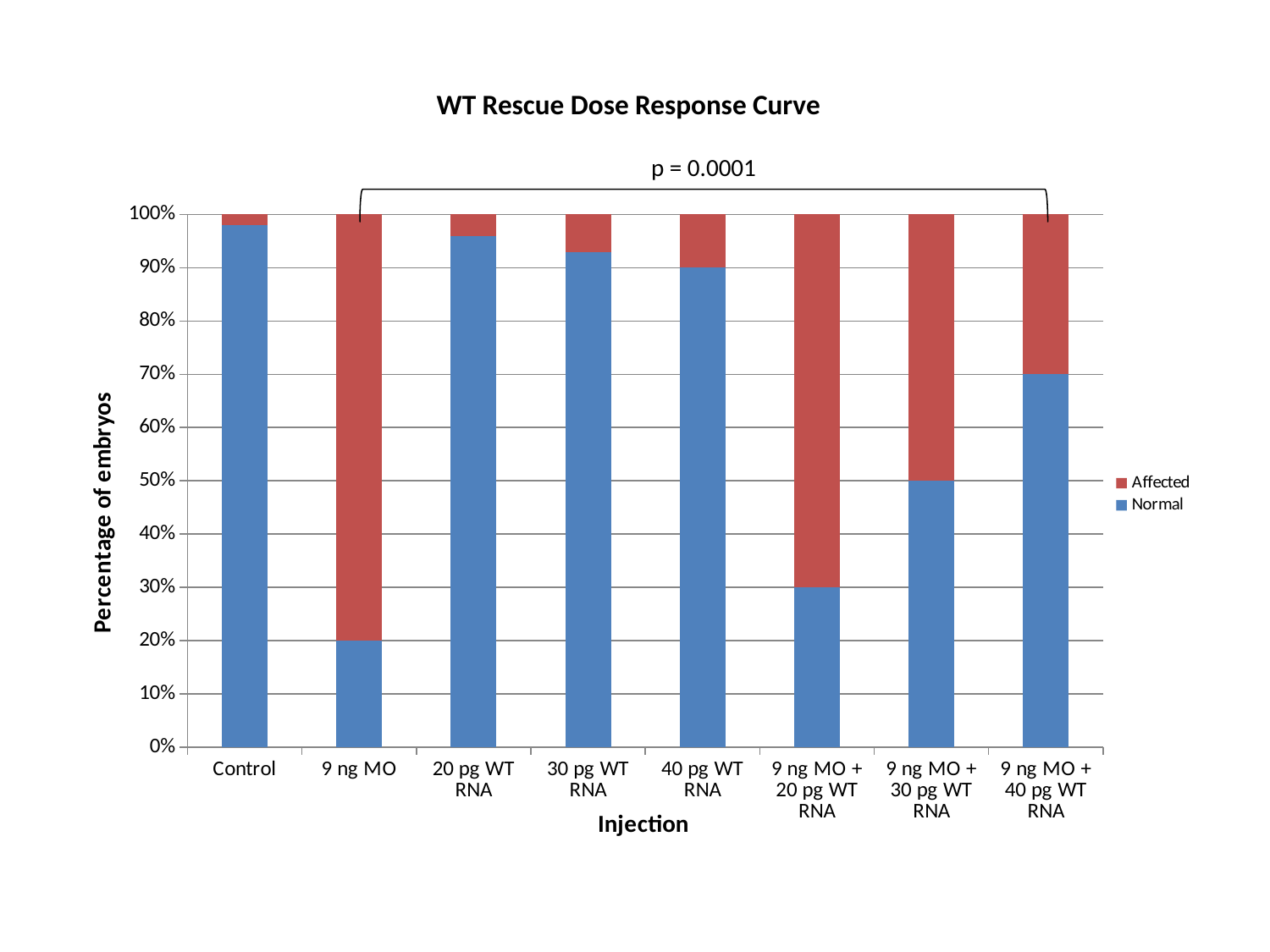
Is the Normal percentage for Control greater or less than 90%? greater Which has a higher Normal percentage: 9 ng MO + 20 pg WT RNA or 9 ng MO + 40 pg WT RNA? 9 ng MO + 40 pg WT RNA Which injection has the lowest Normal percentage? 9 ng MO What is the Normal percentage for the 9 ng MO + 30 pg WT RNA injection? 50% Which injection has the largest Affected share? 9 ng MO What kind of chart is shown on the slide? bar chart How many injection categories are shown on the x axis? 8 What is the Normal percentage for the 9 ng MO injection? 20% How many series does the legend list? 2 What is the Normal percentage for the 9 ng MO + 40 pg WT RNA injection? 70% What is the Normal percentage for the 40 pg WT RNA injection? 90% What is the difference in Normal percentage between 9 ng MO + 40 pg WT RNA and 9 ng MO? 50%